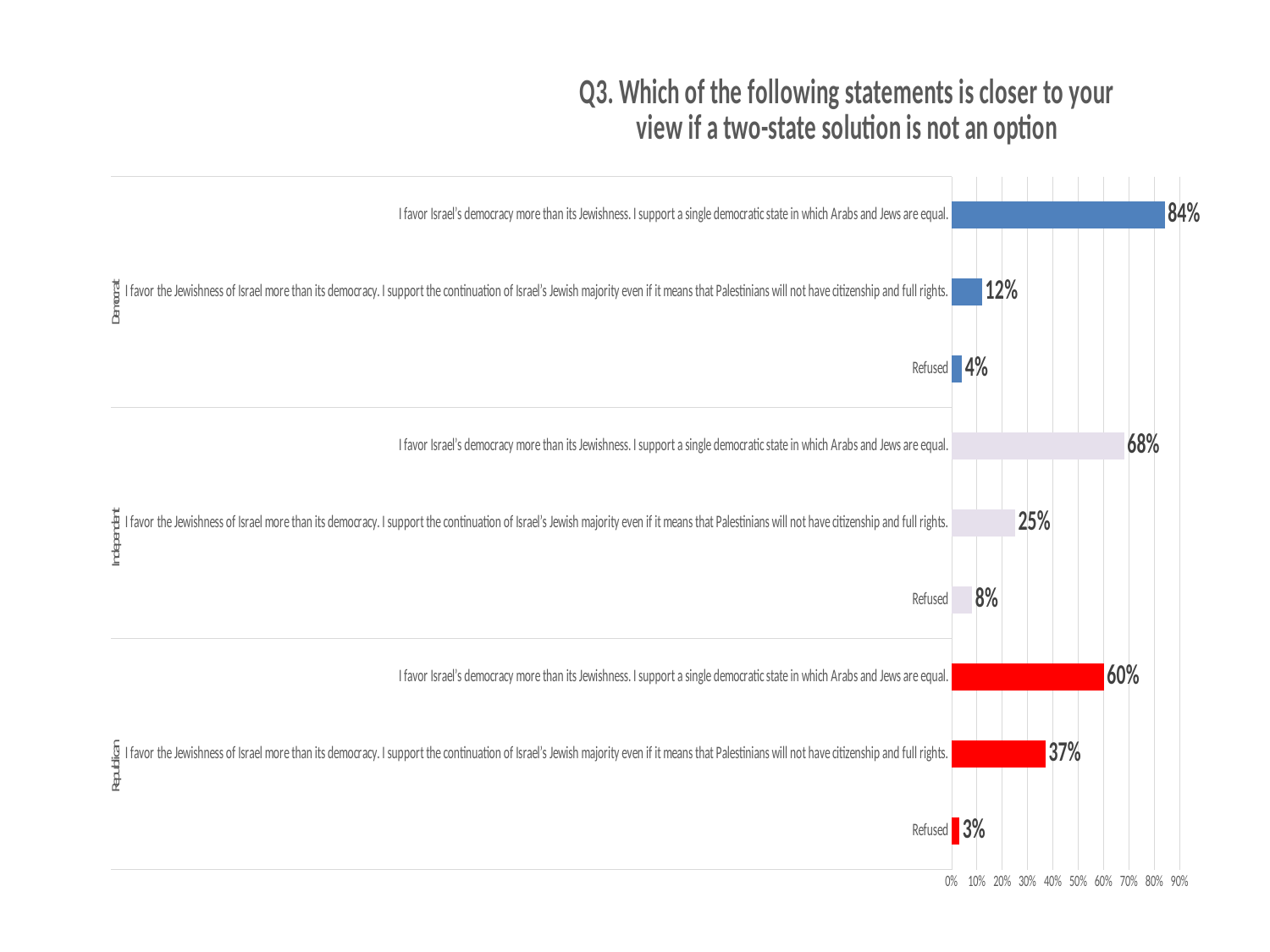
What percentage of Democrats favor Israel's democracy more than its Jewishness? 84% How many party groups are shown on the chart? 3 What percentage of Republicans favor the Jewishness of Israel more than its democracy? 37% What percentage of Independents refused to answer? 8% What is the difference between the Democrat and Republican shares favoring Israel's democracy more than its Jewishness? 24% What percentage of Independents favor Israel's democracy more than its Jewishness? 68% What is the difference between the Republican and Democrat shares favoring the Jewishness of Israel more than its democracy? 25% Which party group has the highest share favoring Israel's democracy more than its Jewishness? Democrat Which is larger: the Independent share favoring Jewishness over democracy or the Republican share favoring Jewishness over democracy? Republican Which party group has the lowest share refusing to answer? Republican What type of chart is shown on the slide? Bar chart What colour are the bars for the Republican group? Red